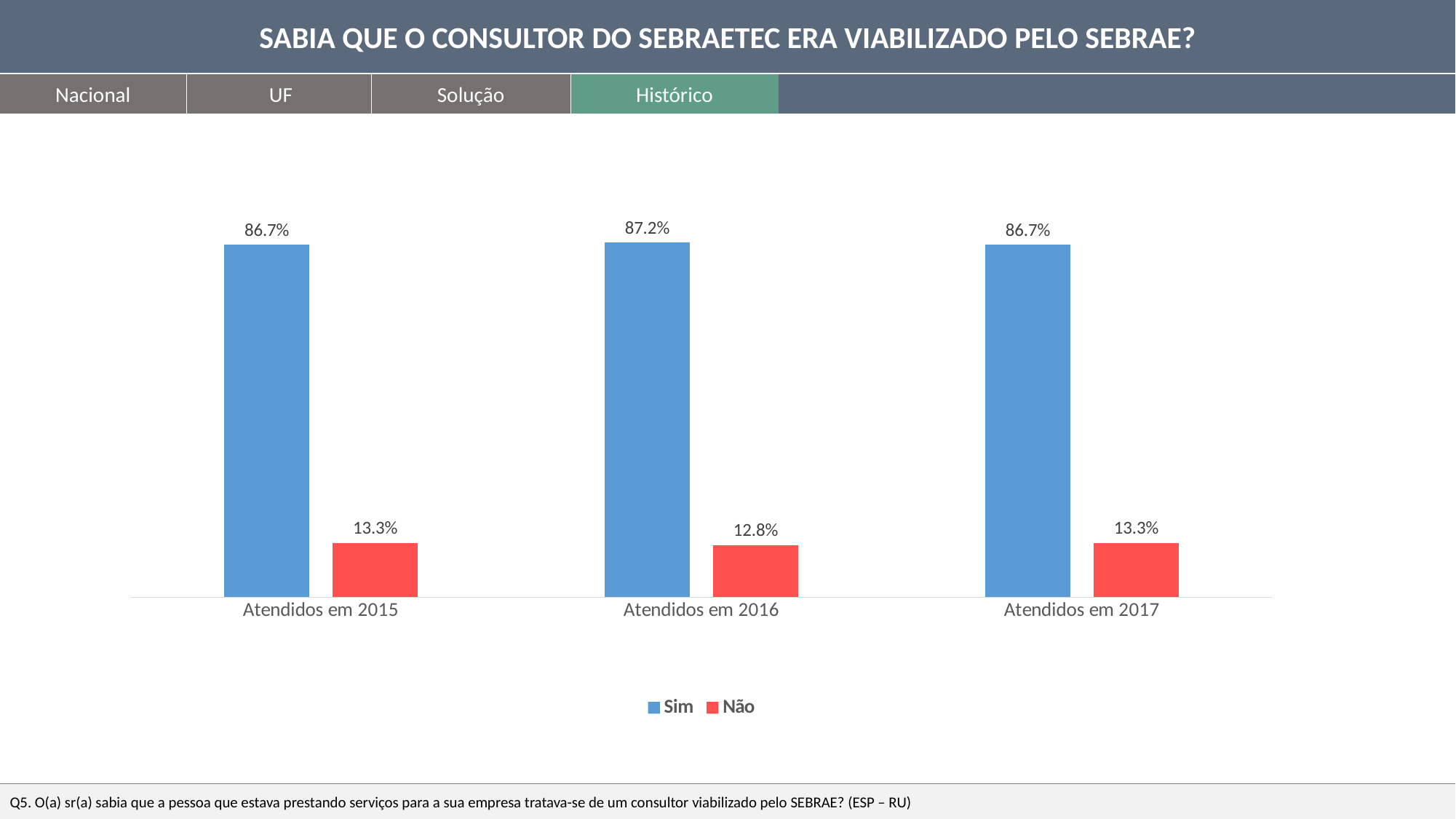
Which category has the lowest "Não" value? Atendidos em 2016 What is the value of "Sim" for "Atendidos em 2015"? 86.7% How many categories are shown on the x axis? 3 Which is larger for "Atendidos em 2017": "Sim" or "Não"? Sim What kind of chart is shown on the slide? Bar chart What is the value of "Não" for "Atendidos em 2016"? 12.8% Which category has the highest "Sim" value? Atendidos em 2016 Which colour represents the "Não" series? Red What is the value of "Sim" for "Atendidos em 2017"? 86.7% How many series does the legend list? 2 What is the difference between the "Sim" and "Não" values for "Atendidos em 2016"? 74.4% What is the value of "Não" for "Atendidos em 2015"? 13.3%